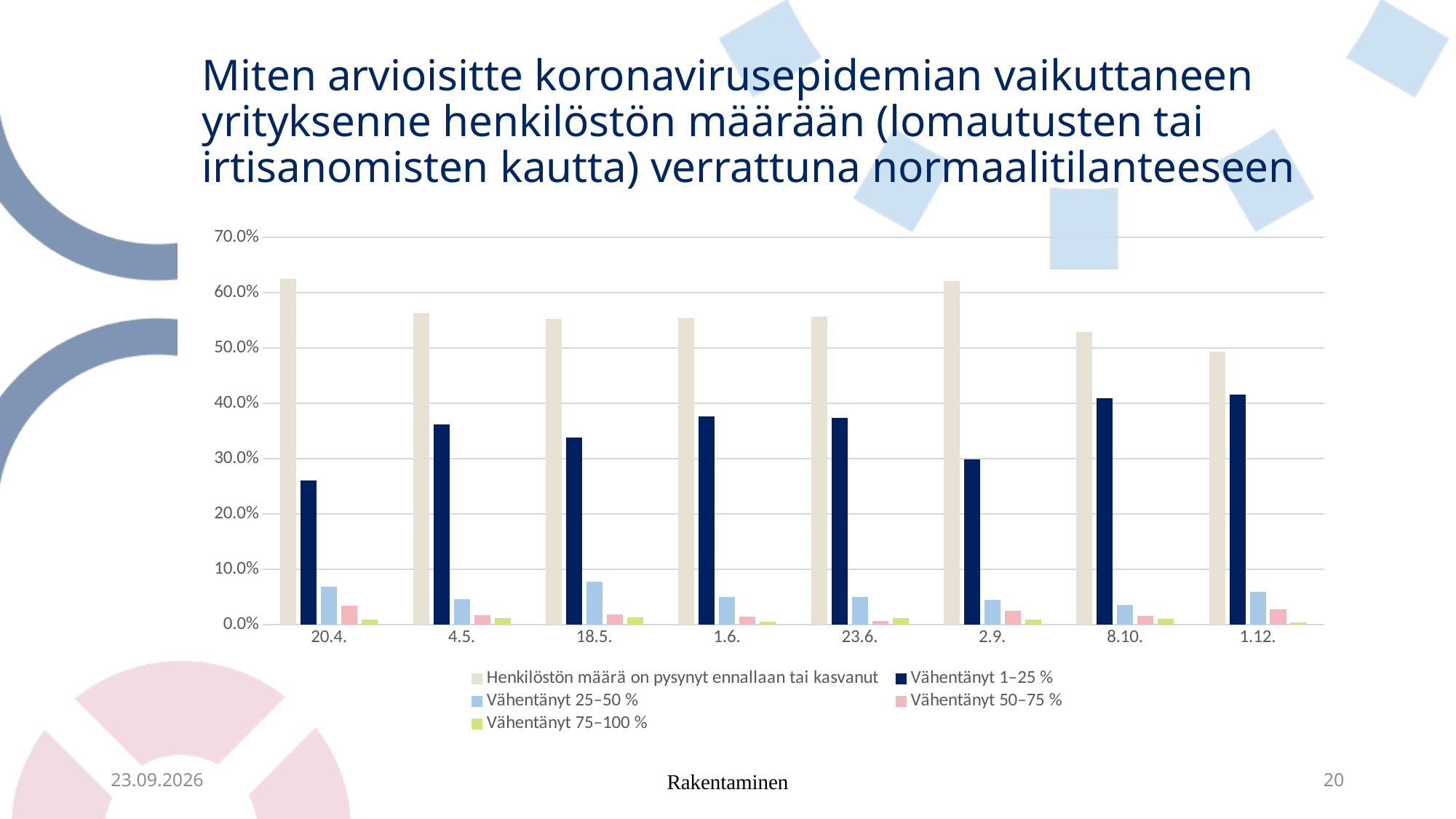
At 1.12., which is larger: 'Henkilöstön määrä on pysynyt ennallaan tai kasvanut' or 'Vähentänyt 1–25 %'? Henkilöstön määrä on pysynyt ennallaan tai kasvanut Is the value for 'Henkilöstön määrä on pysynyt ennallaan tai kasvanut' at 1.12. greater or less than 50.0%? less How many series does the legend list? 5 At which date is the value for 'Vähentänyt 1–25 %' lowest? 20.4. How many dates (categories) are shown on the x axis? 8 What kind of chart is shown on the slide? bar chart At which date is the value for 'Henkilöstön määrä on pysynyt ennallaan tai kasvanut' lowest? 1.12. Is the value for 'Vähentänyt 25–50 %' at 18.5. greater or less than 10.0%? less For 'Vähentänyt 1–25 %', which date has the larger value: 1.6. or 2.9.? 1.6. Is the value for 'Vähentänyt 1–25 %' at 8.10. greater or less than 40.0%? greater